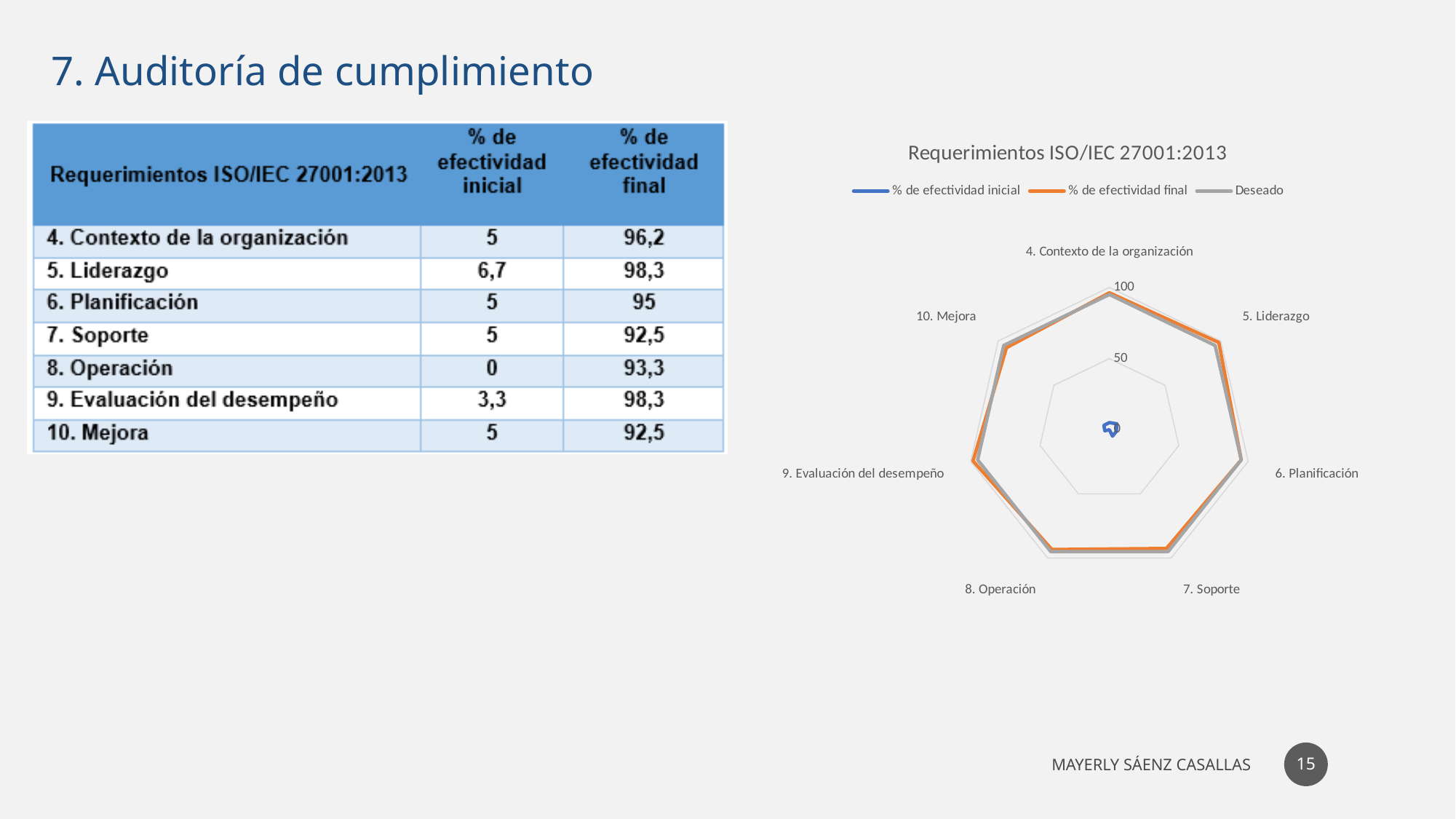
Is the value of % de efectividad inicial for 5. Liderazgo greater or less than 50? less According to the table, which is larger: the % de efectividad final for 5. Liderazgo or for 6. Planificación? 5. Liderazgo Is the value of % de efectividad final for 8. Operación greater or less than 50? greater According to the table, which requirement has the lowest % de efectividad inicial? 8. Operación What is the title of the chart? Requerimientos ISO/IEC 27001:2013 Which series is drawn in orange in the chart? % de efectividad final How many series does the chart legend list? 3 How many categories (axes) does the radar chart have? 7 According to the table, what is the % de efectividad inicial for 8. Operación? 0 What kind of chart is shown on the right of the slide? radar chart Is the Deseado value for 6. Planificación greater or less than 50? greater According to the table, what is the % de efectividad final for 7. Soporte? 92,5